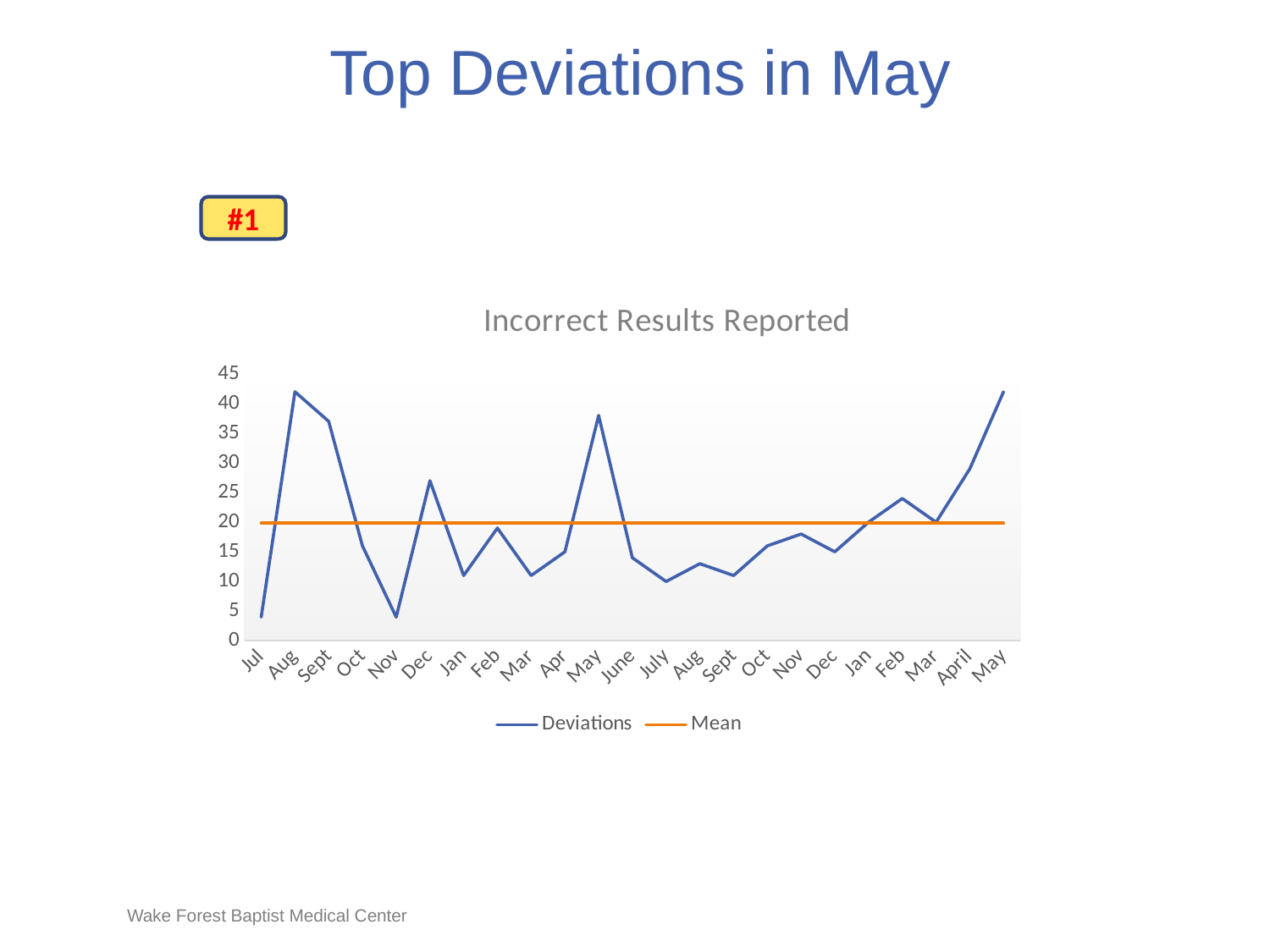
What are the two series named in the legend? Deviations and Mean Which has the larger Deviations value, April or June? April What kind of chart is shown on the slide? line chart Is the Deviations value for April greater or less than 25? greater How many series does the legend list? 2 What is the title of the chart? Incorrect Results Reported Which has the larger Deviations value, the first Sept or the first Oct on the x axis? Sept Is the Deviations value for the first Dec on the x axis greater or less than 20? greater Is the Deviations value for June greater or less than 20? less How many months are plotted along the x axis? 23 Do the Deviations values rise or fall from the second Jan through the final May on the x axis? rise